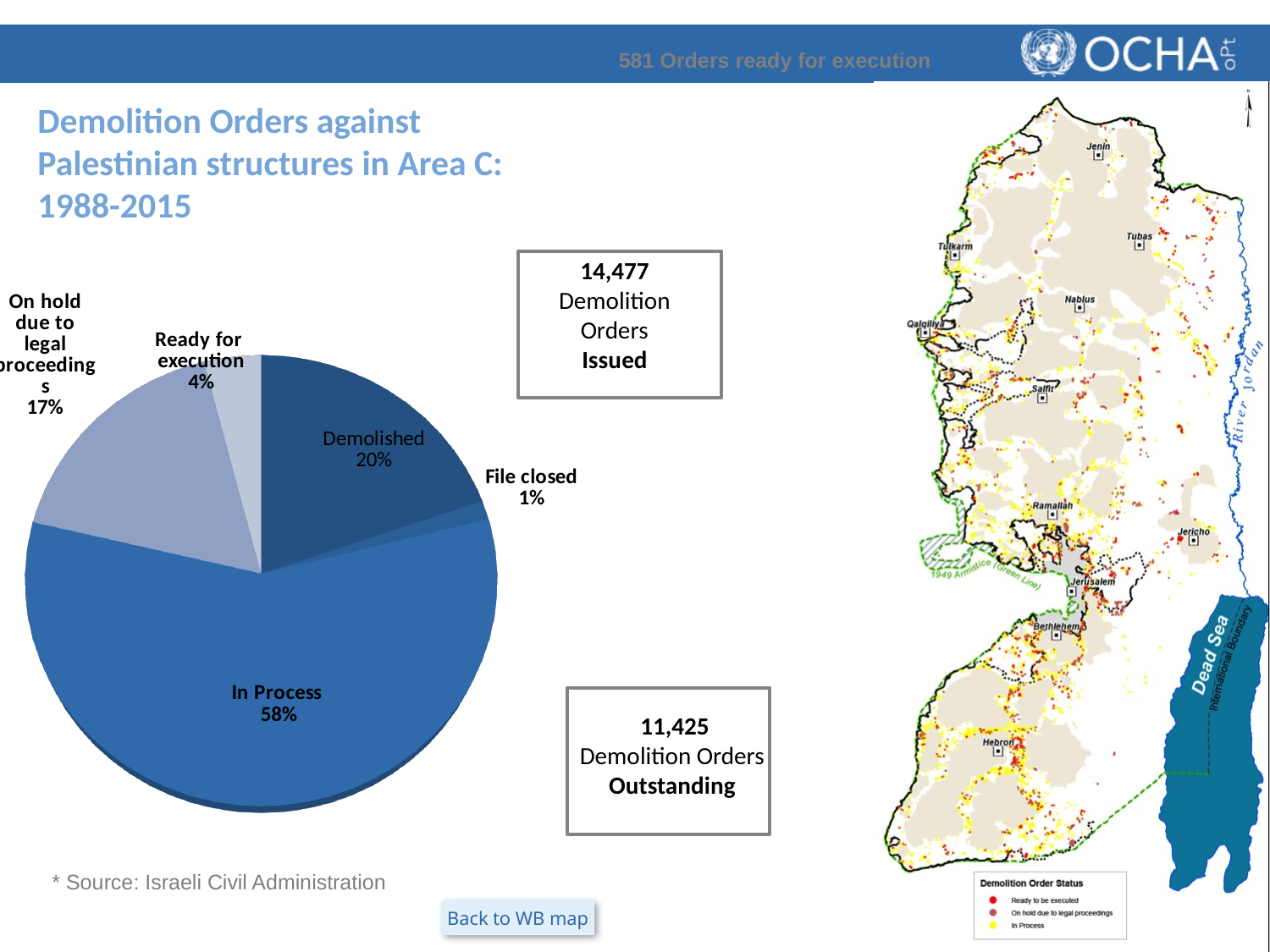
What kind of chart is shown on the slide? pie chart What is the title of the chart on the slide? Demolition Orders against Palestinian structures in Area C: 1988-2015 Which slice of the pie is the largest? In Process What is the difference in percentage points between the In Process slice and the Demolished slice? 38 Which slice of the pie is the smallest? File closed What share of the pie is labelled Demolished? 20% Which is larger, the Demolished slice or the On hold due to legal proceedings slice? Demolished What share of the pie is labelled On hold due to legal proceedings? 17% What share of the pie is labelled In Process? 58% How many slices does the pie chart have? 5 What share of the pie is labelled Ready for execution? 4% What share of the pie is labelled File closed? 1%